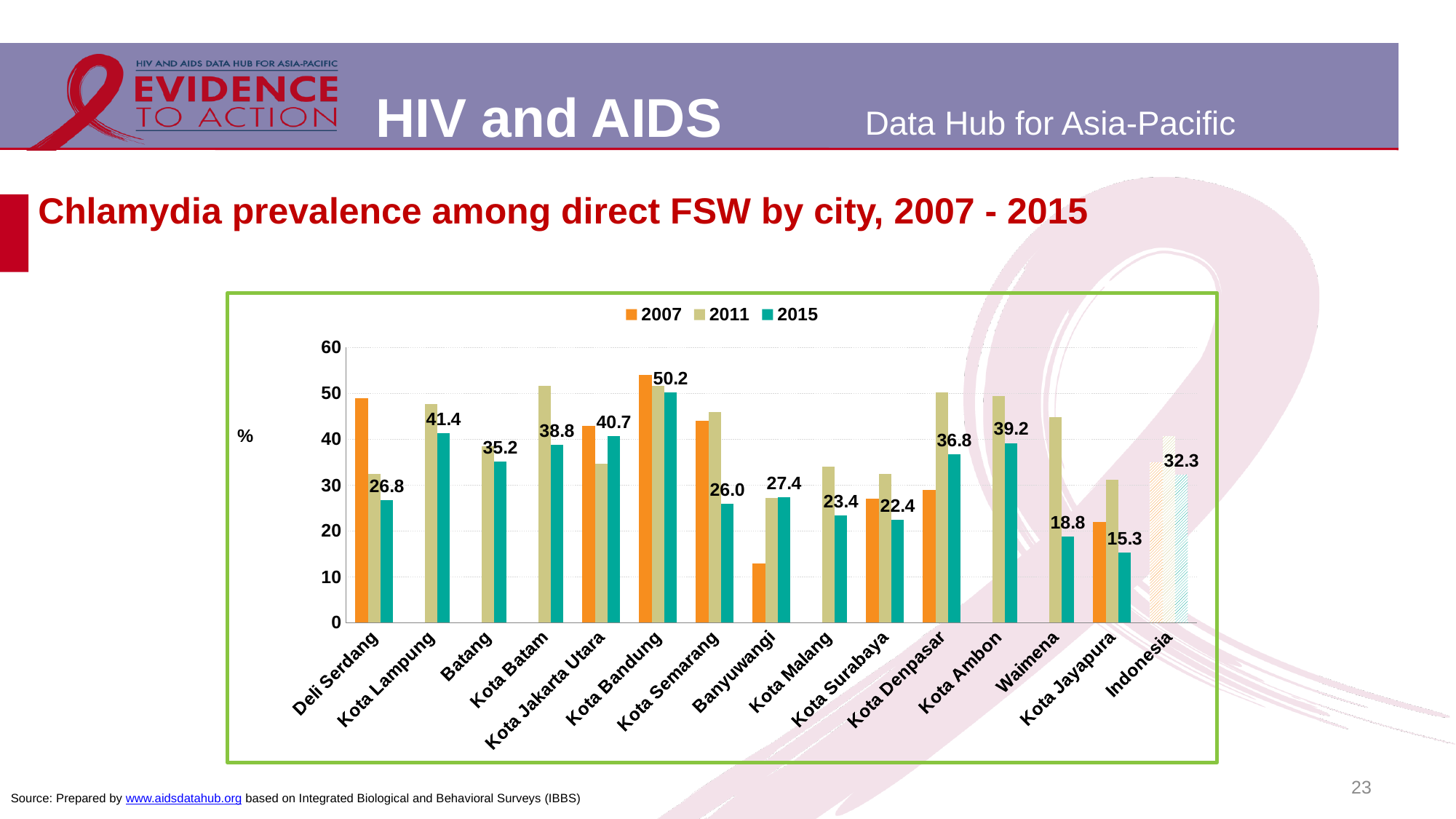
What is the 2015 value for Kota Jayapura? 15.3 What is the 2015 chlamydia prevalence among direct FSW in Kota Bandung? 50.2 Which city has the highest 2015 value? Kota Bandung Is the 2007 value for Kota Bandung greater or less than 50? greater How many cities/categories are shown on the x axis? 15 What is the 2015 value for Indonesia? 32.3 How many series does the legend list? 3 Which city has the lowest 2015 value? Kota Jayapura Which has the larger 2015 value, Kota Ambon or Kota Denpasar? Kota Ambon What type of chart is shown on the slide? Bar chart What is the difference between the 2015 values for Kota Bandung and Kota Jayapura? 34.9 Is the 2007 value for Banyuwangi greater or less than 20? less